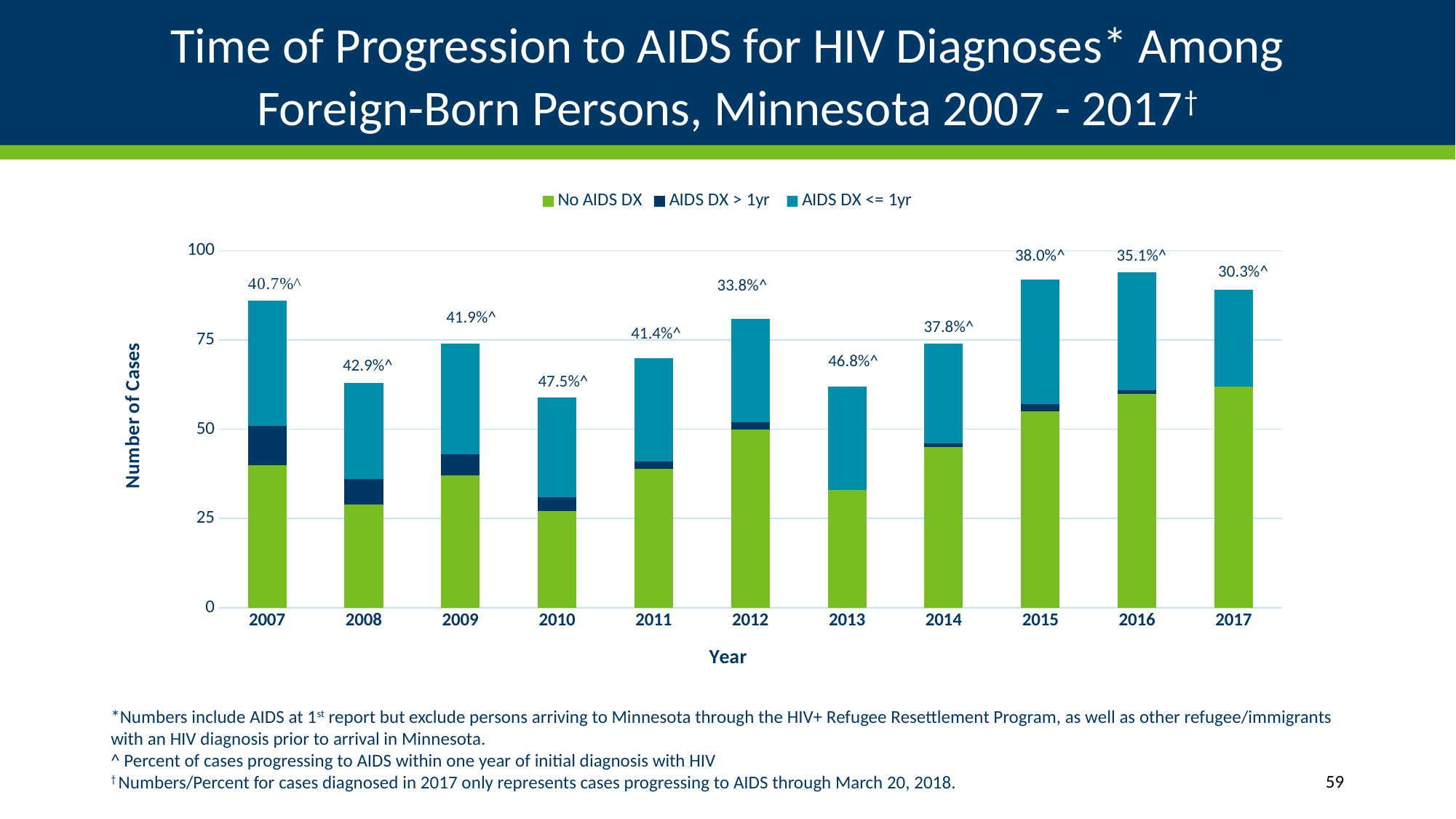
What is the difference in percentage points between the 2010 label (47.5%) and the 2017 label (30.3%)? 17.2 Do the percentage labels rise or fall from 2015 to 2017? fall Which year has the larger percentage label, 2008 or 2009? 2008 Is the No AIDS DX value for 2017 greater or less than 50? greater What percentage label is shown above the 2010 bar? 47.5% What percentage label is shown above the 2017 bar? 30.3% Is the total number of cases for 2016 greater or less than 75? greater How many series does the legend list? 3 Which year has the lowest percentage of cases progressing to AIDS within one year? 2017 Is the total number of cases for 2013 greater or less than 75? less How many years are shown on the x axis? 11 Which year has the highest percentage of cases progressing to AIDS within one year? 2010